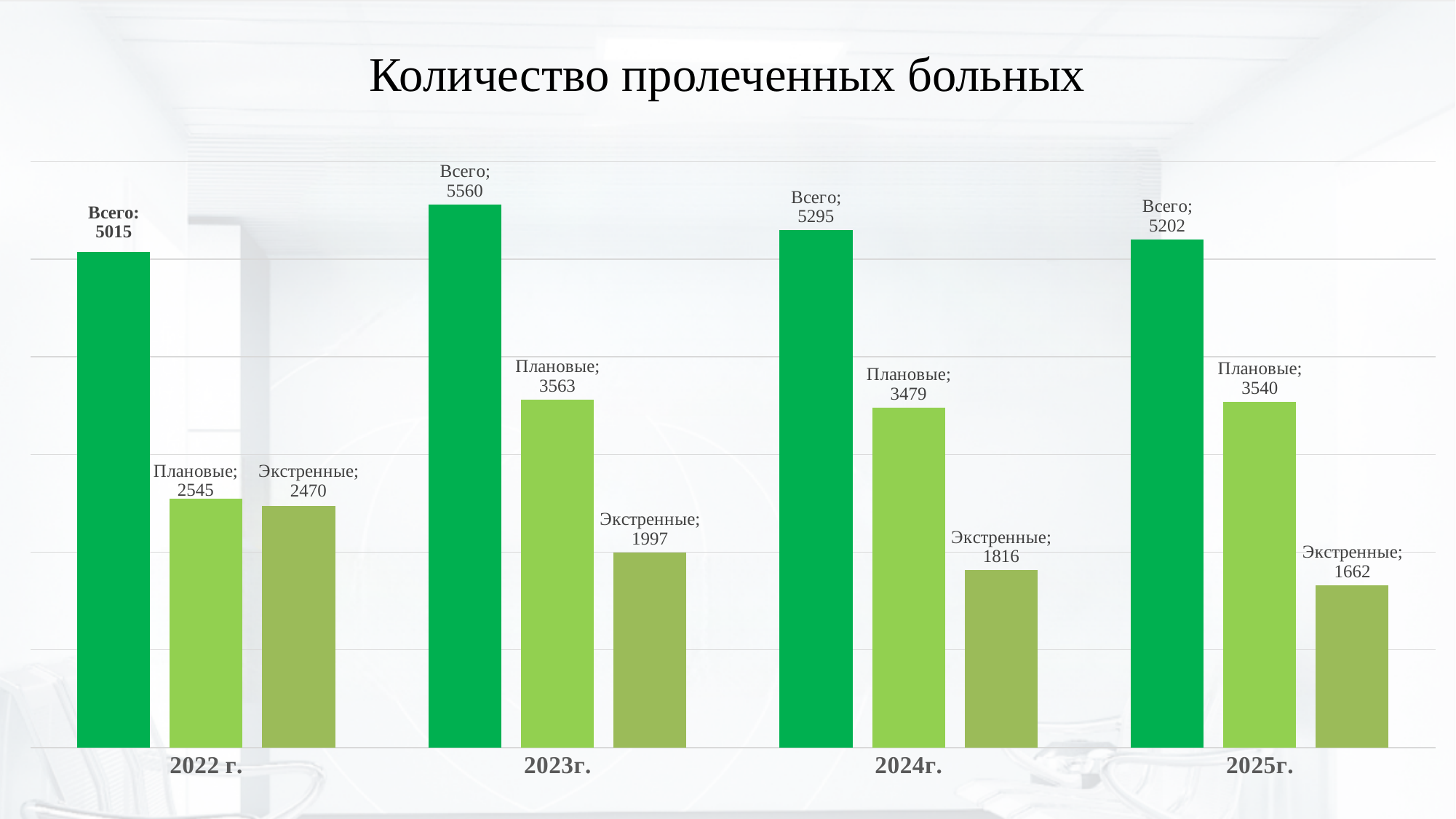
How many years are shown on the x axis? 4 Which is larger: Плановые in 2023г. or Плановые in 2025г.? Плановые in 2023г. What is the value of Плановые for 2024г.? 3479 Do the Экстренные values rise or fall from 2022 г. to 2025г.? Fall What is the difference between the Всего values for 2023г. and 2024г.? 265 What is the value of Всего for 2023г.? 5560 What is the value of Экстренные for 2025г.? 1662 Which year has the lowest Экстренные value? 2025г. What kind of chart is shown on the slide? Bar chart What is the title of the chart? Количество пролеченных больных What is the difference between Плановые and Экстренные in 2022 г.? 75 Which year has the highest Всего value? 2023г.